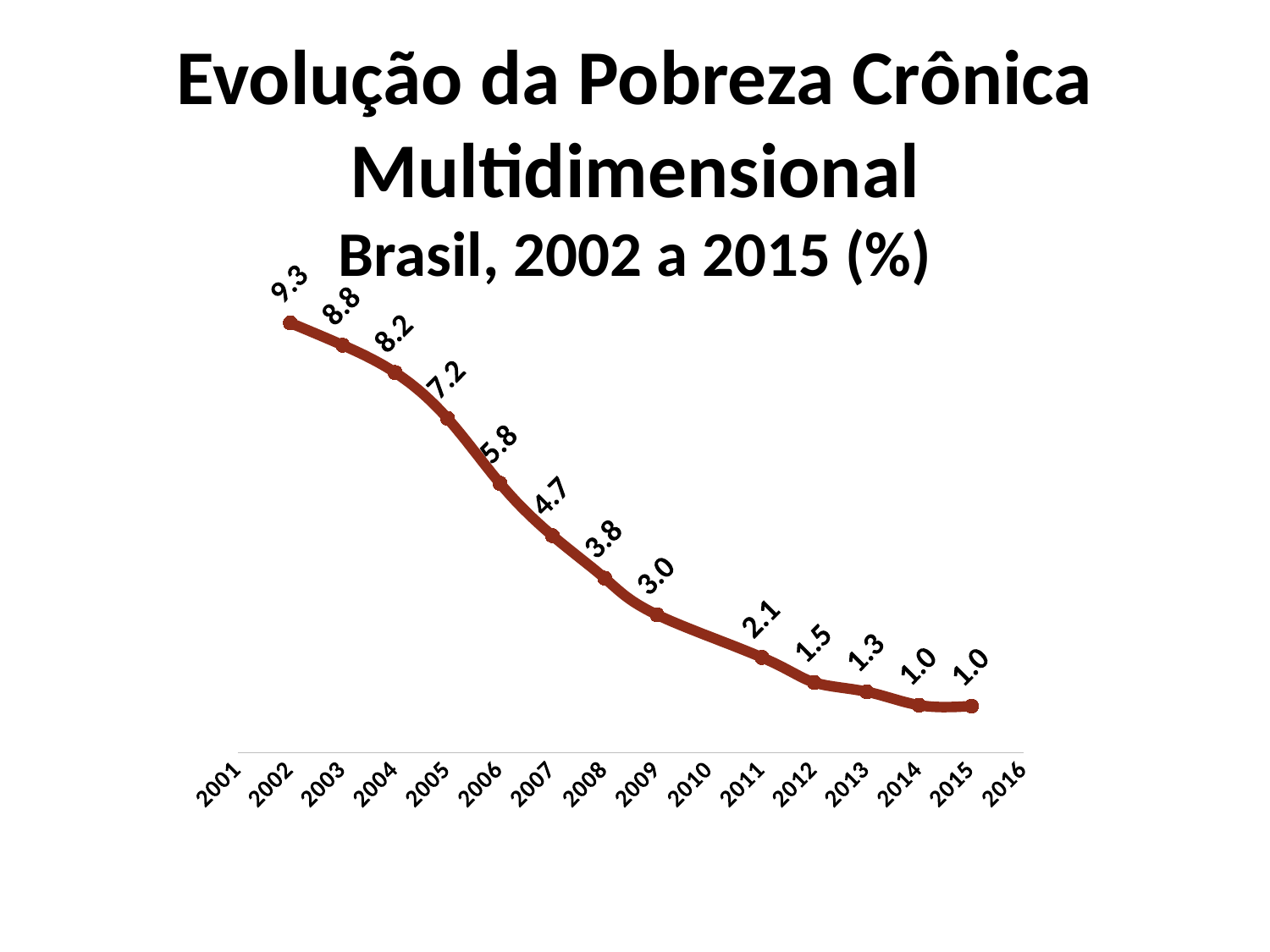
What is the value for 2009? 3.0 Do the values rise or fall from 2002 to 2015? fall What is the value for 2015? 1.0 What is the value for 2005? 7.2 Which is larger, the value for 2008 or the value for 2011? 2008 Which year has the highest value? 2002 What is the difference between the values for 2006 and 2007? 1.1 What type of chart is shown on the slide? line chart What is the title of the chart? Evolução da Pobreza Crônica Multidimensional Brasil, 2002 a 2015 (%) What is the difference between the values for 2002 and 2015? 8.3 What is the value for 2002? 9.3 What is the lowest value shown on the chart? 1.0